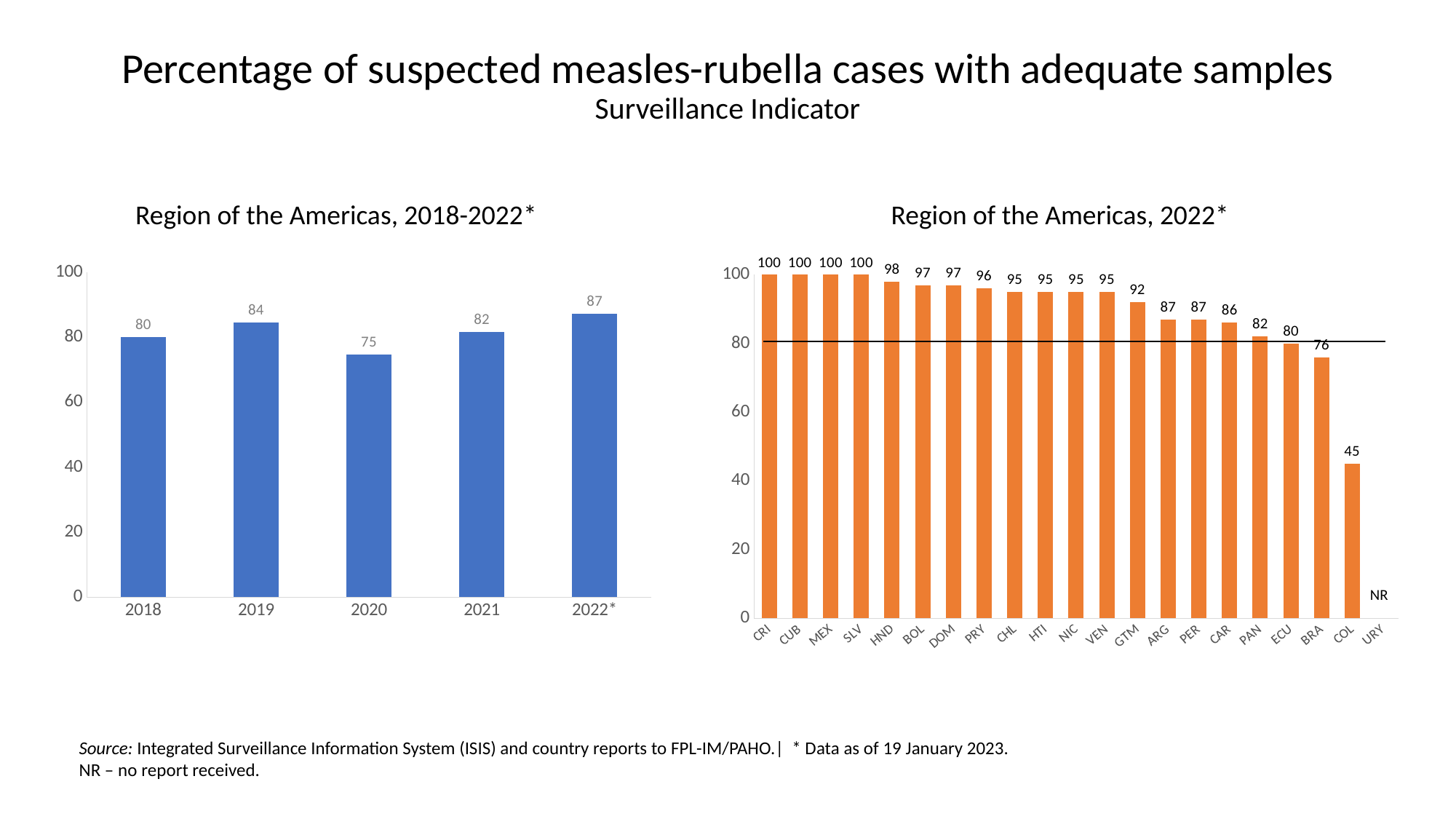
In the 'Region of the Americas, 2022*' chart, what is the value for COL? 45 In the 'Region of the Americas, 2022*' chart, which country has the lowest plotted value? COL In the 'Region of the Americas, 2022*' chart, which is larger, the value for HND or the value for BRA? HND In the 'Region of the Americas, 2018-2022*' chart, which year has the highest value? 2022* In the 'Region of the Americas, 2018-2022*' chart, which year has the lowest value? 2020 What kind of chart is the 'Region of the Americas, 2018-2022*' chart? bar chart In the 'Region of the Americas, 2018-2022*' chart, what is the value for 2020? 75 In the 'Region of the Americas, 2022*' chart, what is the difference between the values for PAN and COL? 37 In the 'Region of the Americas, 2018-2022*' chart, what is the difference between the values for 2022* and 2018? 7 In the 'Region of the Americas, 2022*' chart, what label is shown for URY instead of a bar? NR In the 'Region of the Americas, 2022*' chart, what is the value for GTM? 92 In the 'Region of the Americas, 2018-2022*' chart, how many years are shown on the x axis? 5